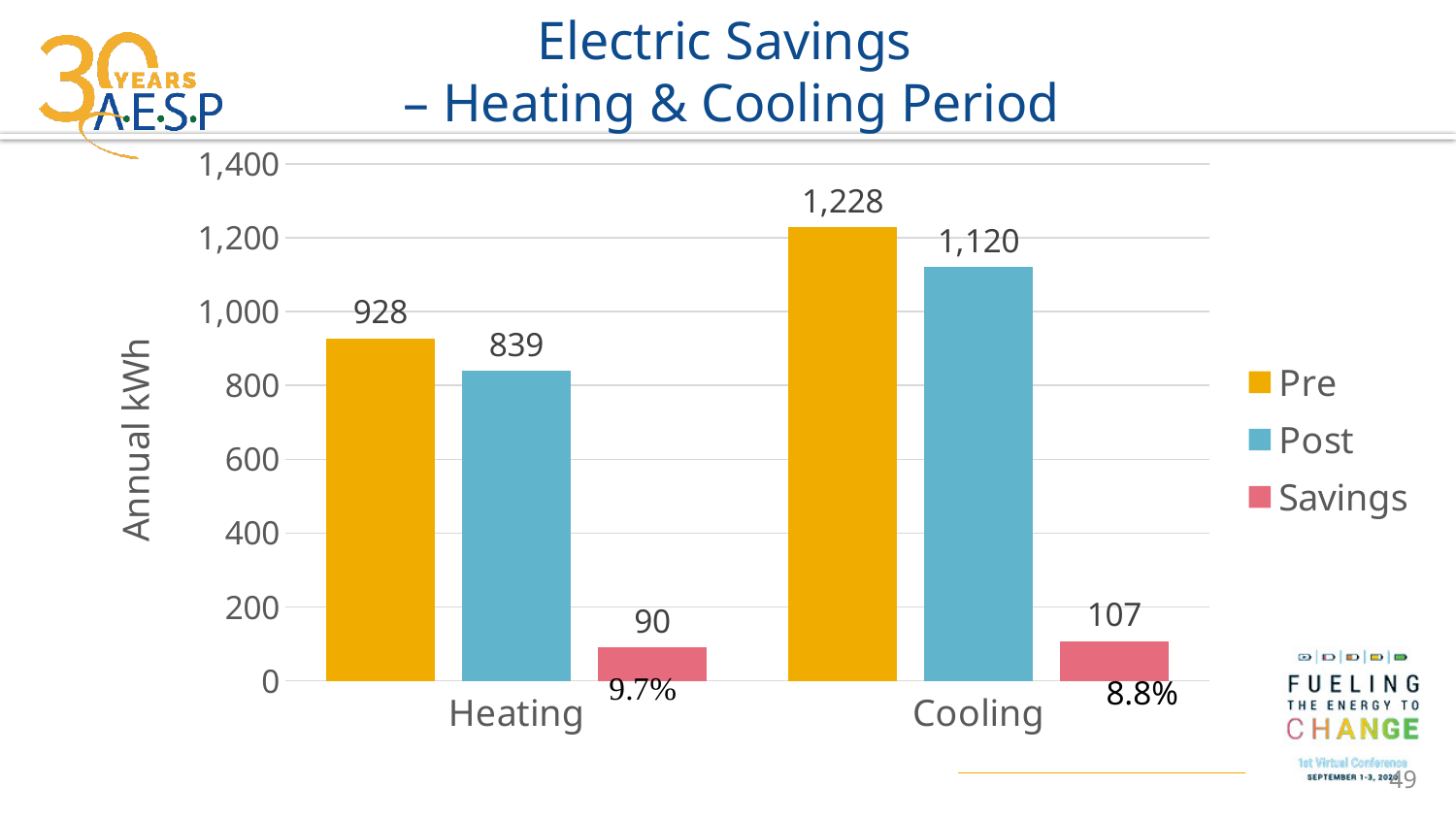
How many series does the legend list? 3 How many categories are shown on the x axis? 2 What is the Pre value for Heating? 928 What is the Savings value for Cooling? 107 What kind of chart is shown on the slide? Bar chart What is the Post value for Cooling? 1,120 Is the Post value for Cooling greater or less than 1,000? greater Which series has the lowest value for Cooling? Savings What percentage savings is shown for Heating? 9.7% Which category has the higher Pre value, Heating or Cooling? Cooling What is the difference between the Pre values for Cooling and Heating? 300 What is the difference between the Pre and Post values for Heating? 89